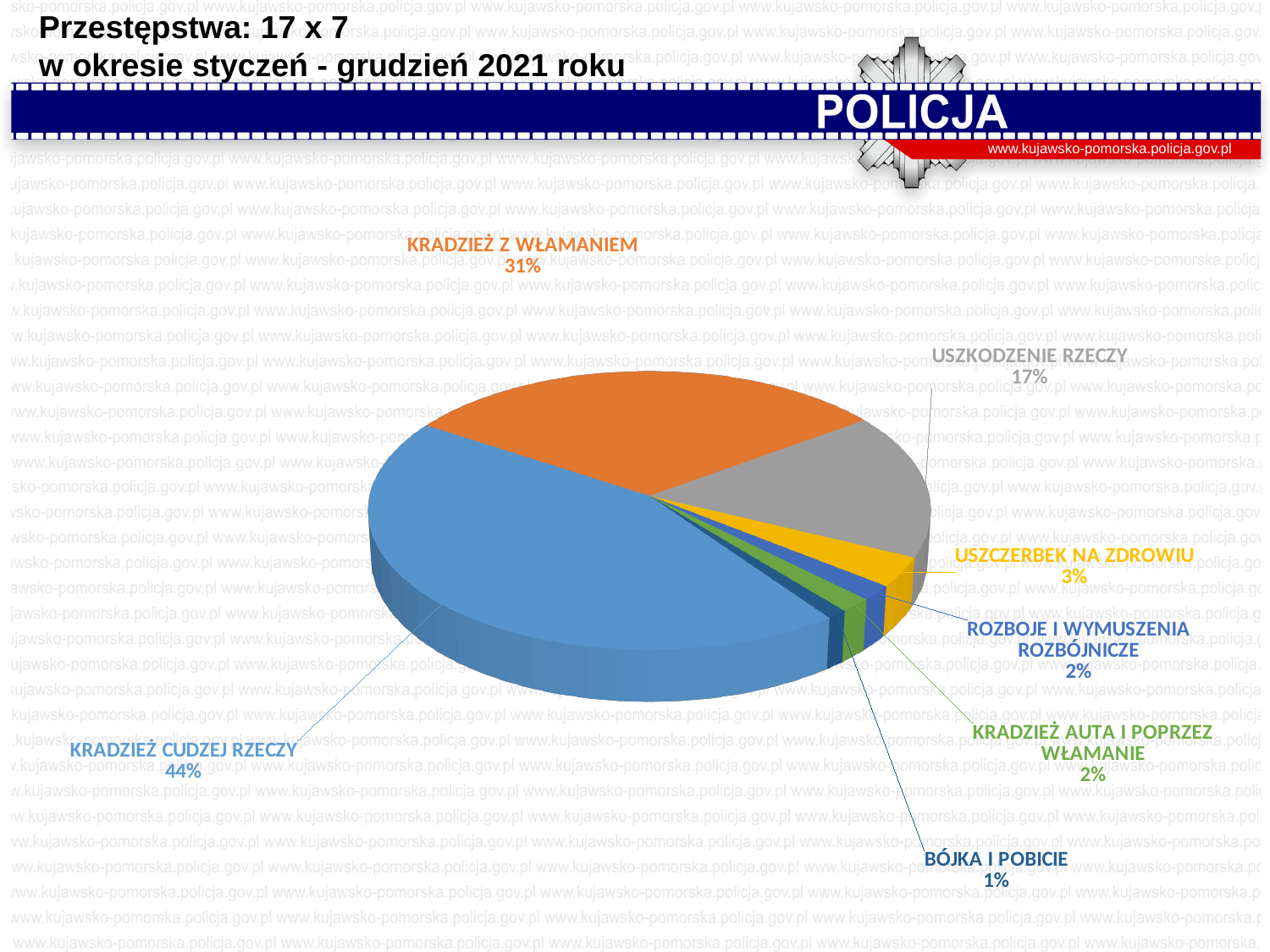
What kind of chart is shown on the slide? pie chart What share of the pie does BÓJKA I POBICIE have? 1% What is the difference in percentage points between KRADZIEŻ CUDZEJ RZECZY and KRADZIEŻ Z WŁAMANIEM? 13 What share of the pie does USZCZERBEK NA ZDROWIU have? 3% Which category has the smallest slice of the pie? BÓJKA I POBICIE Which category has the largest slice of the pie? KRADZIEŻ CUDZEJ RZECZY Which is larger, the share for USZKODZENIE RZECZY or the share for USZCZERBEK NA ZDROWIU? USZKODZENIE RZECZY How many categories are shown in the pie chart? 7 What period does the slide title say the data covers? styczeń - grudzień 2021 roku What share of the pie does KRADZIEŻ Z WŁAMANIEM have? 31%